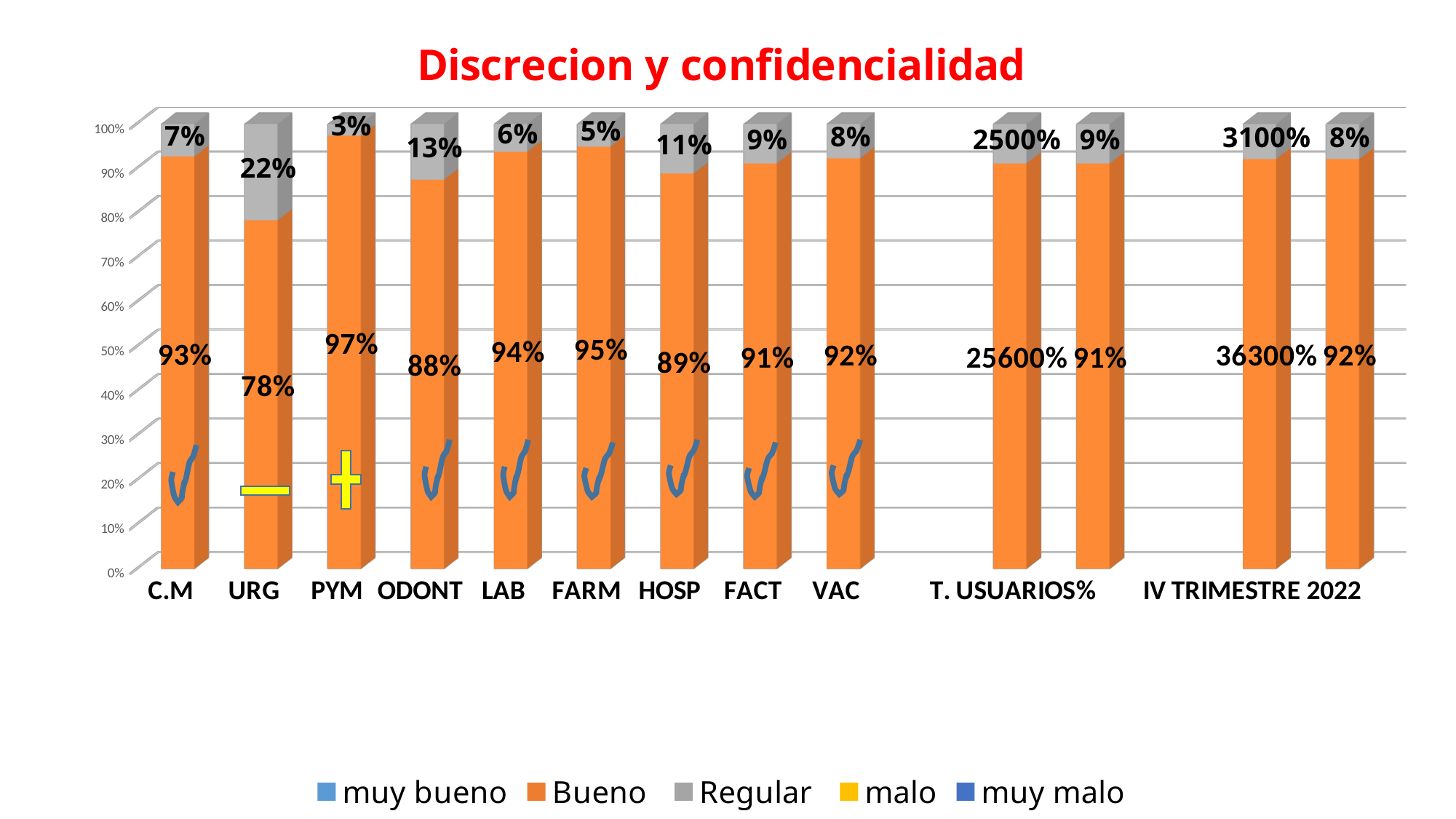
Which is larger, the Regular value for ODONT or the Regular value for FACT? ODONT What is the Regular value for URG? 22% How many series does the legend list? 5 What is the Bueno value for PYM? 97% Among C.M, URG, PYM, ODONT, LAB, FARM, HOSP, FACT and VAC, which category has the lowest Bueno value? URG What is the title of the chart? Discrecion y confidencialidad What is the Regular value for HOSP? 11% Is the Bueno value for URG greater or less than 80%? less Among C.M, URG, PYM, ODONT, LAB, FARM, HOSP, FACT and VAC, which category has the highest Bueno value? PYM What is the Bueno value for ODONT? 88% What type of chart is shown on the slide? Stacked bar chart What is the difference between the Bueno values for FARM and HOSP? 6%